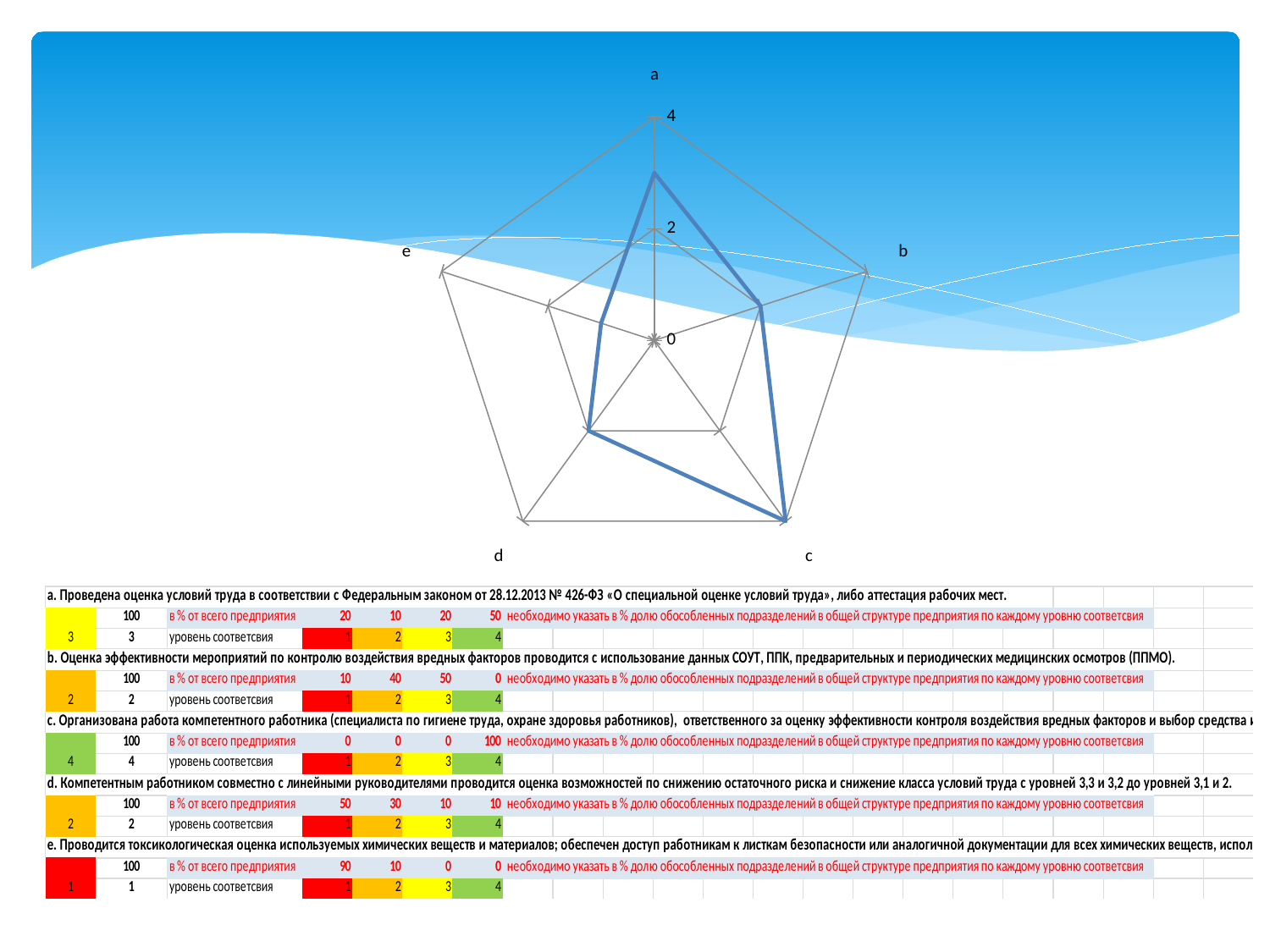
What kind of chart is shown on the slide? radar chart What is the value for category d on the radar chart? 2 How many categories (axes) does the radar chart have? 5 What is the value for category c on the radar chart? 4 Which is larger on the radar chart, the value for c or the value for e? c Which category has the highest value on the radar chart? c Which category has the lowest value on the radar chart? e What is the maximum value shown on the radar chart's axis scale? 4 Which is larger on the radar chart, the value for a or the value for b? a Is the value for category e greater or less than 2? less Is the value for category a greater or less than 2? greater What is the value for category b on the radar chart? 2